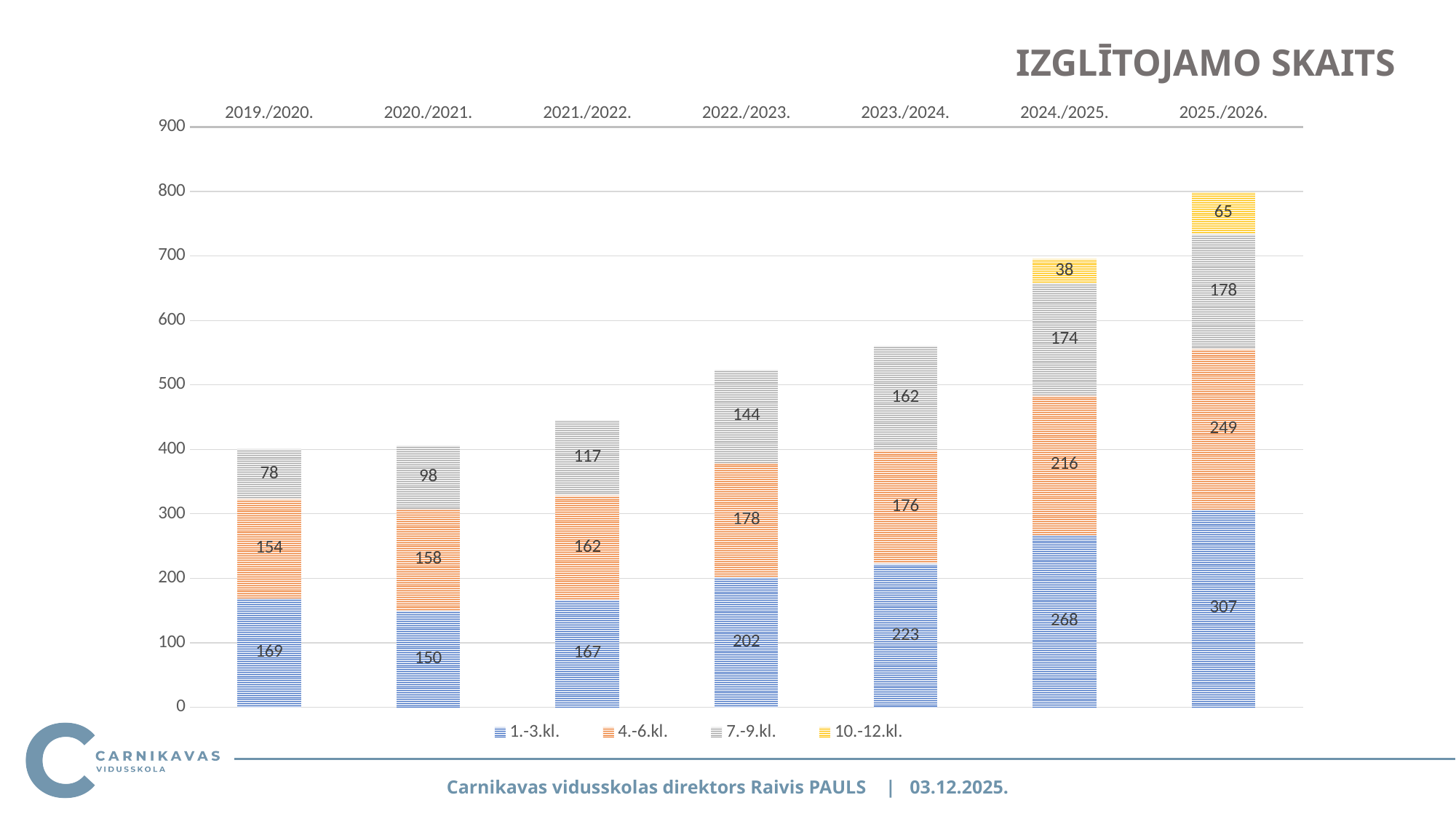
What is the difference between the 1.-3.kl. values for 2025./2026. and 2024./2025.? 39 Which school year has the highest value for 4.-6.kl.? 2025./2026. What is the value for 10.-12.kl. in 2024./2025.? 38 What kind of chart is shown on the slide? Stacked bar chart What is the total of the stacked bar for 2019./2020.? 401 How many school years are shown on the x axis? 7 What is the value for 7.-9.kl. in 2022./2023.? 144 Which school year has the lowest value for 1.-3.kl.? 2020./2021. What is the total of the stacked bar for 2025./2026.? 799 Which is larger: the 7.-9.kl. value in 2023./2024. or the 4.-6.kl. value in 2021./2022.? Neither; they are equal (both 162) How many series does the legend list? 4 What is the value for 1.-3.kl. in 2025./2026.? 307